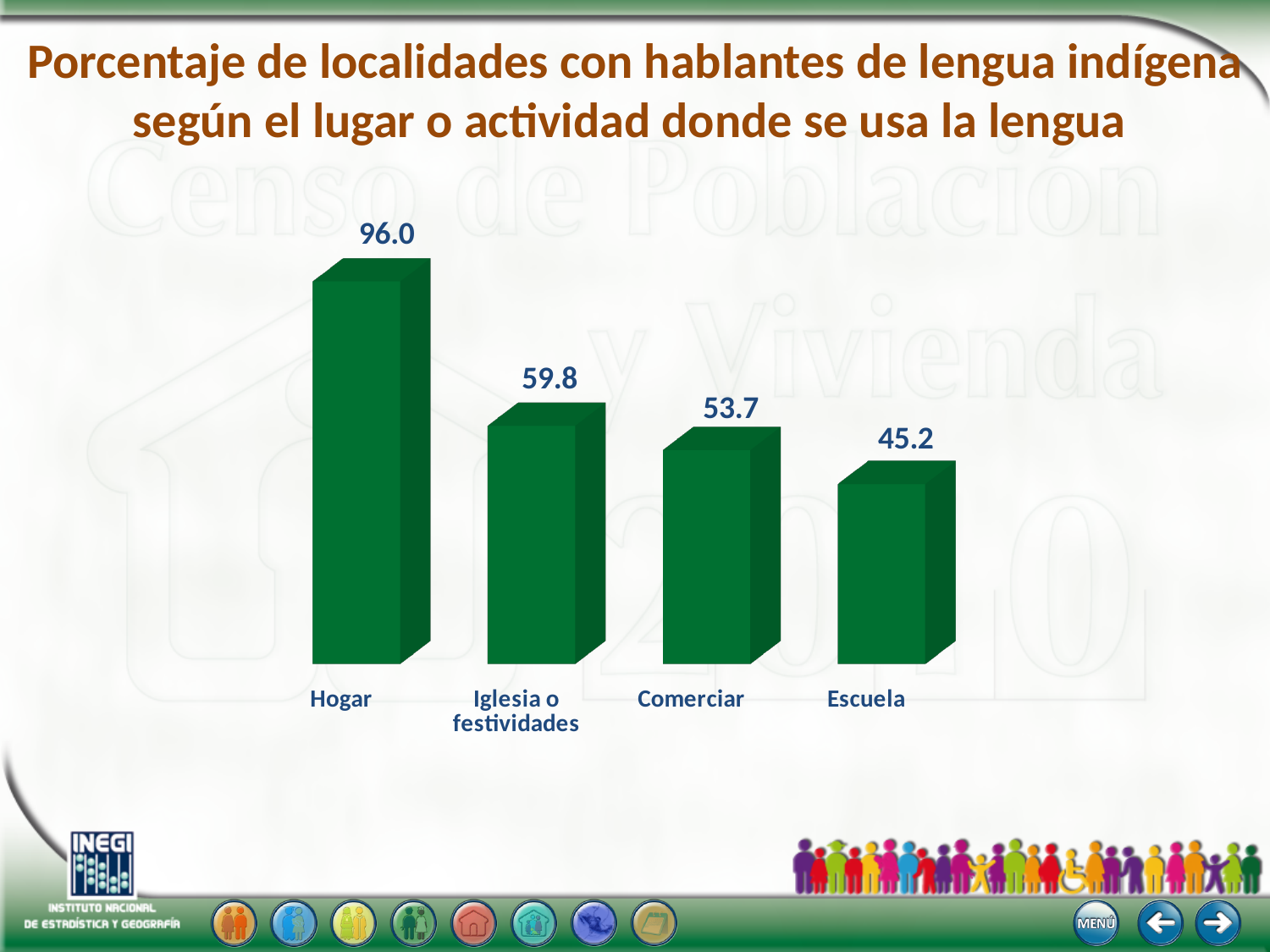
What is the difference between the values for Hogar and Escuela? 50.8 What is the value for Iglesia o festividades? 59.8 Which category has the lowest value? Escuela Which category has the highest value? Hogar What is the value for Escuela? 45.2 What is the value for Comerciar? 53.7 What kind of chart is shown on the slide? bar chart Do the values rise or fall from left to right across the categories? fall What is the value for Hogar? 96.0 What is the difference between the values for Iglesia o festividades and Comerciar? 6.1 How many categories are shown in the chart? 4 Which is larger, the value for Comerciar or the value for Escuela? Comerciar